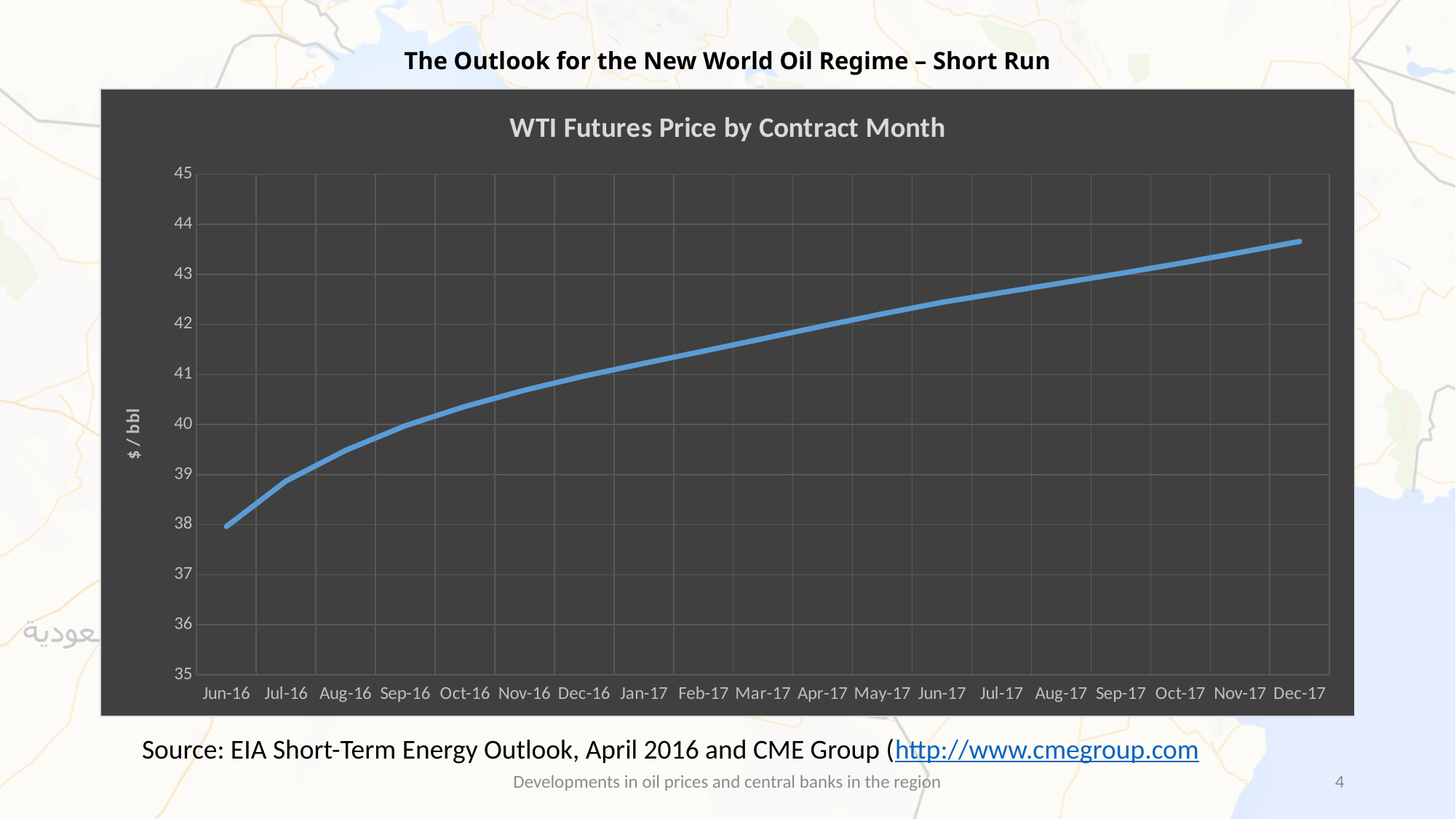
What is the title of the chart? WTI Futures Price by Contract Month Is the value for Jun-16 greater or less than 39? less Do the WTI futures prices rise or fall from Jun-16 to Dec-17? rise Which contract month has the lowest WTI futures price? Jun-16 Which has the larger WTI futures price, Jun-16 or Dec-17? Dec-17 Is the value for Dec-17 greater or less than 43? greater Is the value for Dec-16 greater or less than 40? greater What type of chart is shown on the slide? line chart What is the label on the vertical axis of the chart? $ / bbl Which contract month has the highest WTI futures price? Dec-17 How many contract months are plotted on the x axis? 19